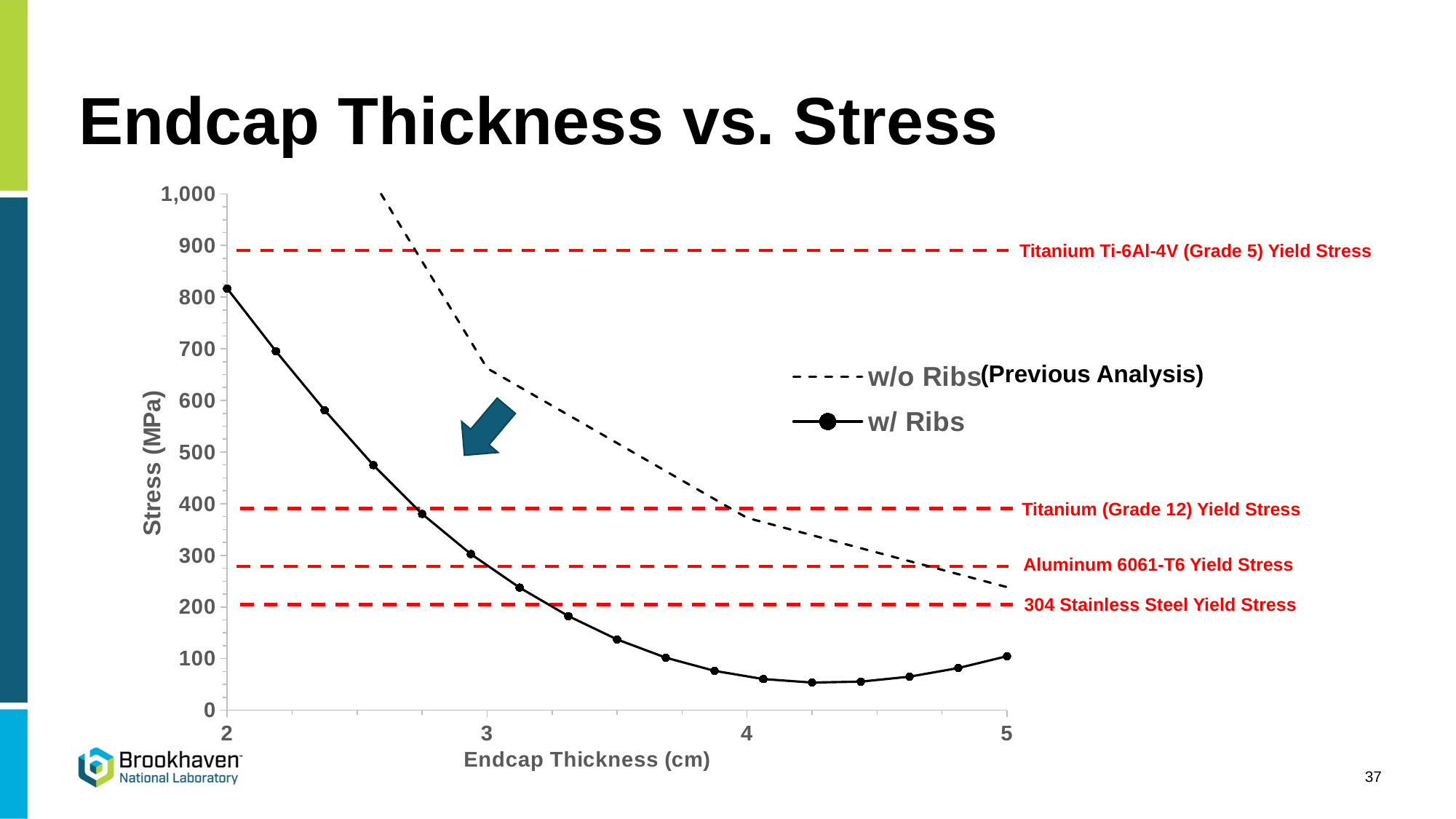
Is the w/ Ribs value at an endcap thickness of 4 cm greater or less than 100? less Is the w/ Ribs value at an endcap thickness of 2 cm greater or less than 700? greater Does the w/o Ribs series rise or fall as endcap thickness increases from 3 cm to 5 cm? fall Is the w/ Ribs value at an endcap thickness of 5 cm greater or less than 200? less How many series does the legend list? 2 What is the label of the y axis? Stress (MPa) At an endcap thickness of 3 cm, which series has the higher stress, w/o Ribs or w/ Ribs? w/o Ribs Between which two x-axis ticks does the w/ Ribs curve reach its lowest stress? between 4 and 5 What kind of chart is shown on the slide? line chart Which series is plotted with a dashed line, w/o Ribs or w/ Ribs? w/o Ribs